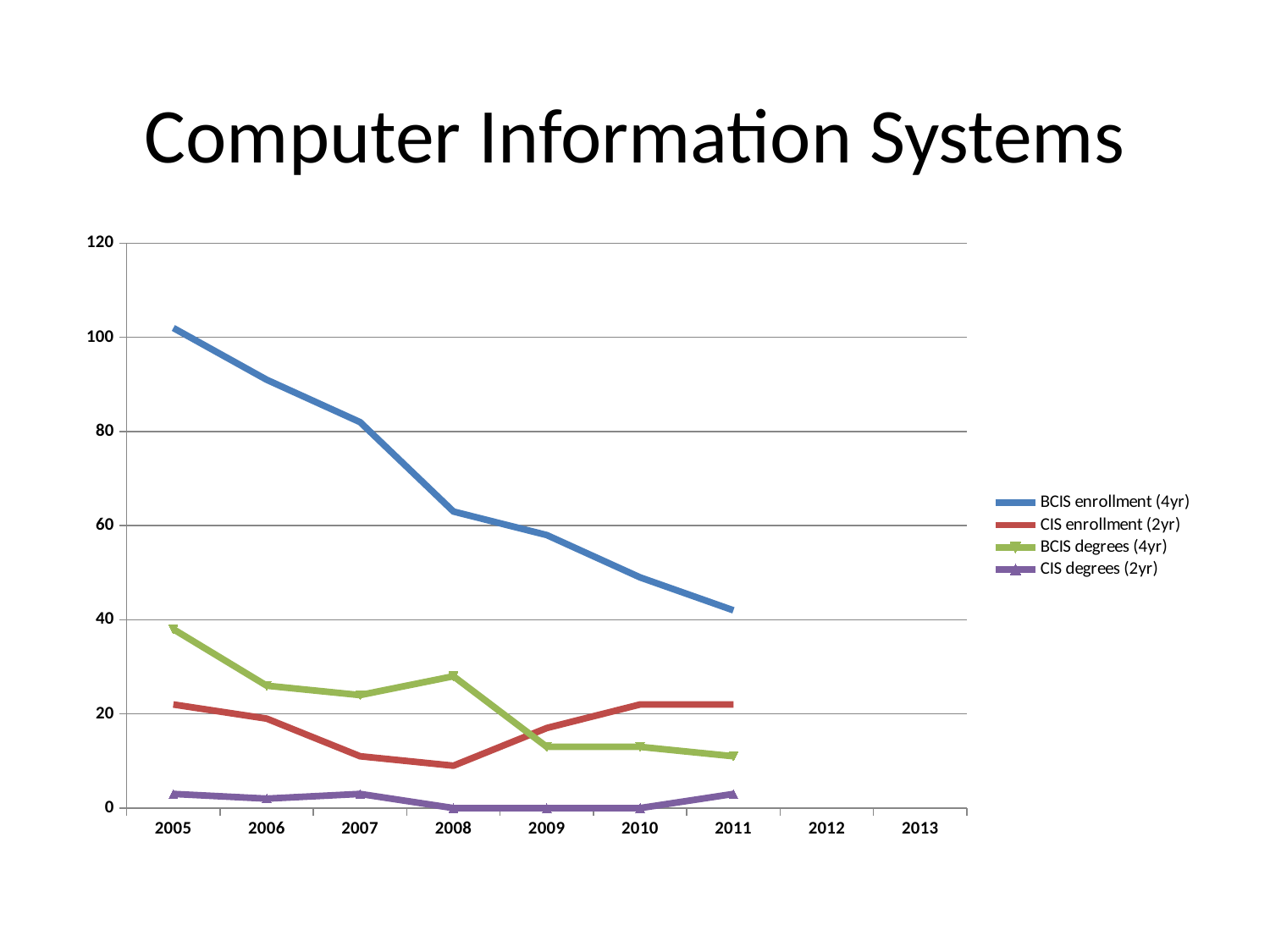
What is the title of the slide containing the chart? Computer Information Systems Is the value for BCIS enrollment (4yr) in 2011 greater or less than 40? greater In 2011, which is larger: CIS enrollment (2yr) or BCIS degrees (4yr)? CIS enrollment (2yr) Is the value for BCIS degrees (4yr) in 2005 greater or less than 40? less How many series does the legend list? 4 Does the BCIS enrollment (4yr) line rise or fall from 2005 to 2011? fall Which series has the lowest value in 2011? CIS degrees (2yr) Is the value for CIS enrollment (2yr) in 2008 greater or less than 20? less What kind of chart is shown on the slide? line chart Which series has the highest value in 2005? BCIS enrollment (4yr) How many year labels are shown on the x axis? 9